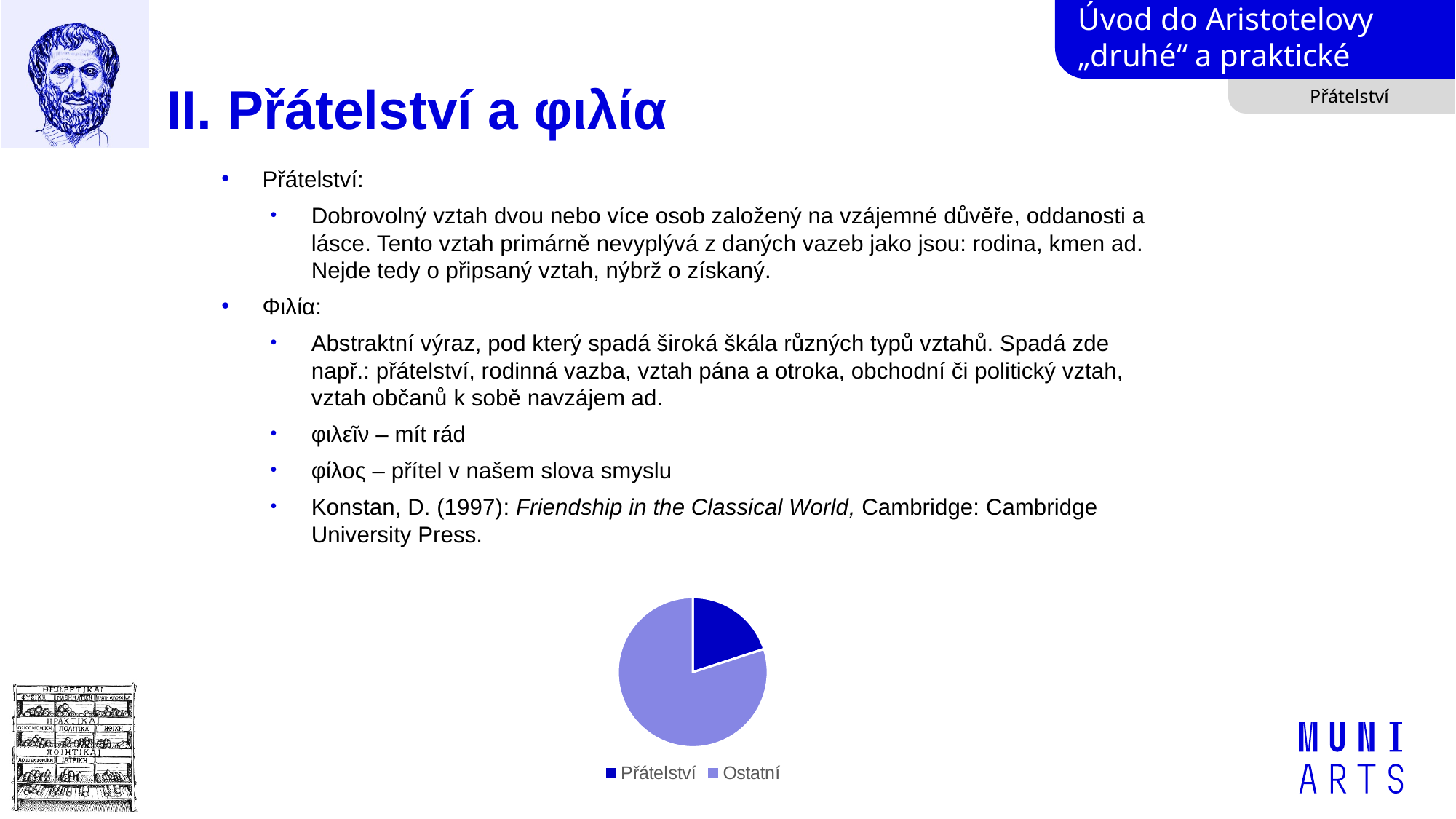
What colour is the Přátelství slice in the pie chart? dark blue Which slice is larger in the pie chart, Přátelství or Ostatní? Ostatní What are the two categories listed in the legend of the pie chart? Přátelství and Ostatní Which slice of the pie chart is the largest? Ostatní Which slice of the pie chart is the smallest? Přátelství How many slices does the pie chart have? 2 How many entries does the legend of the pie chart list? 2 What kind of chart is shown on the slide? pie chart